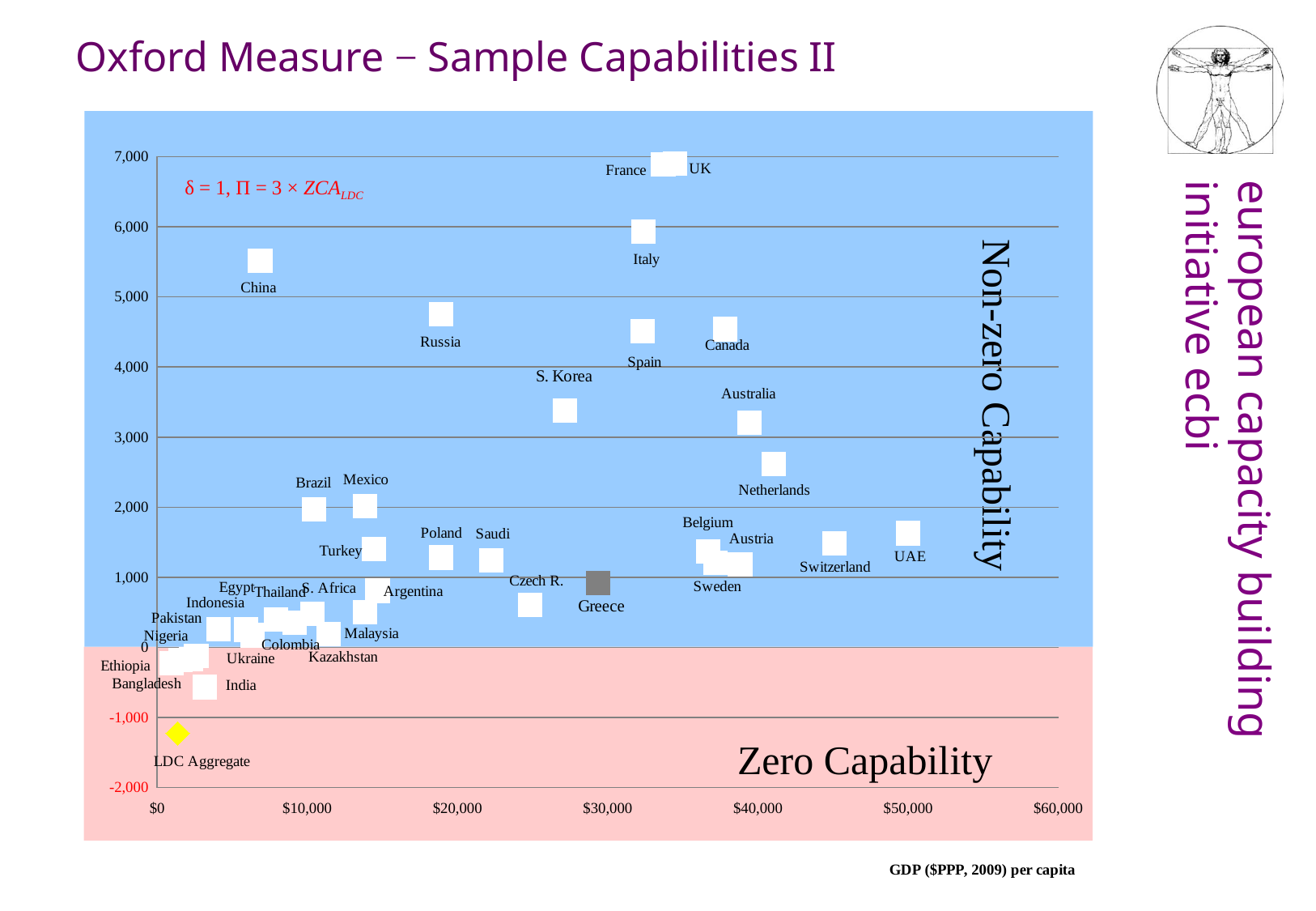
Which point has the lowest value on the chart? LDC Aggregate Is the value for Netherlands greater or less than 3,000? less Is the value for China greater or less than 5,000? greater What kind of chart is shown on the slide? Scatter chart Is the value for Czech R. greater or less than 1,000? less What is the label of the x axis? GDP ($PPP, 2009) per capita Which has the higher value, China or Russia? China What are the two capability regions labelled on the chart? Non-zero Capability and Zero Capability Which has the higher value, Canada or Australia? Canada